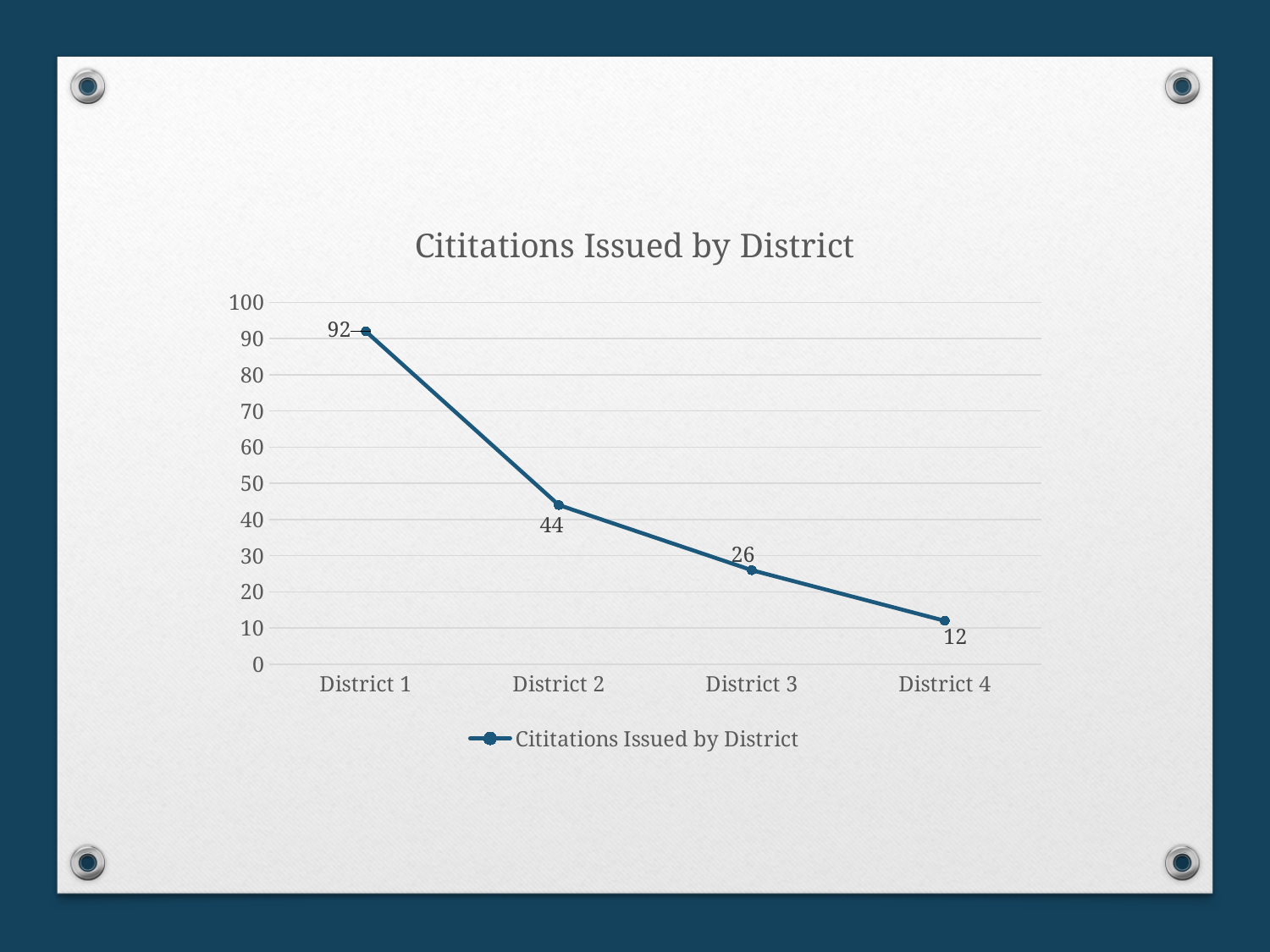
Which district has the lowest number of citations issued? District 4 Which district has the highest number of citations issued? District 1 Do the values rise or fall from District 1 to District 4? Fall What is the difference between the values for District 1 and District 2? 48 What is the value for District 4? 12 How many districts are plotted on the chart? 4 What is the difference between the values for District 3 and District 4? 14 What is the value for District 1? 92 How many series does the legend list? 1 Which is larger, the value for District 2 or the value for District 3? District 2 What kind of chart is shown on the slide? Line chart What is the value for District 3? 26